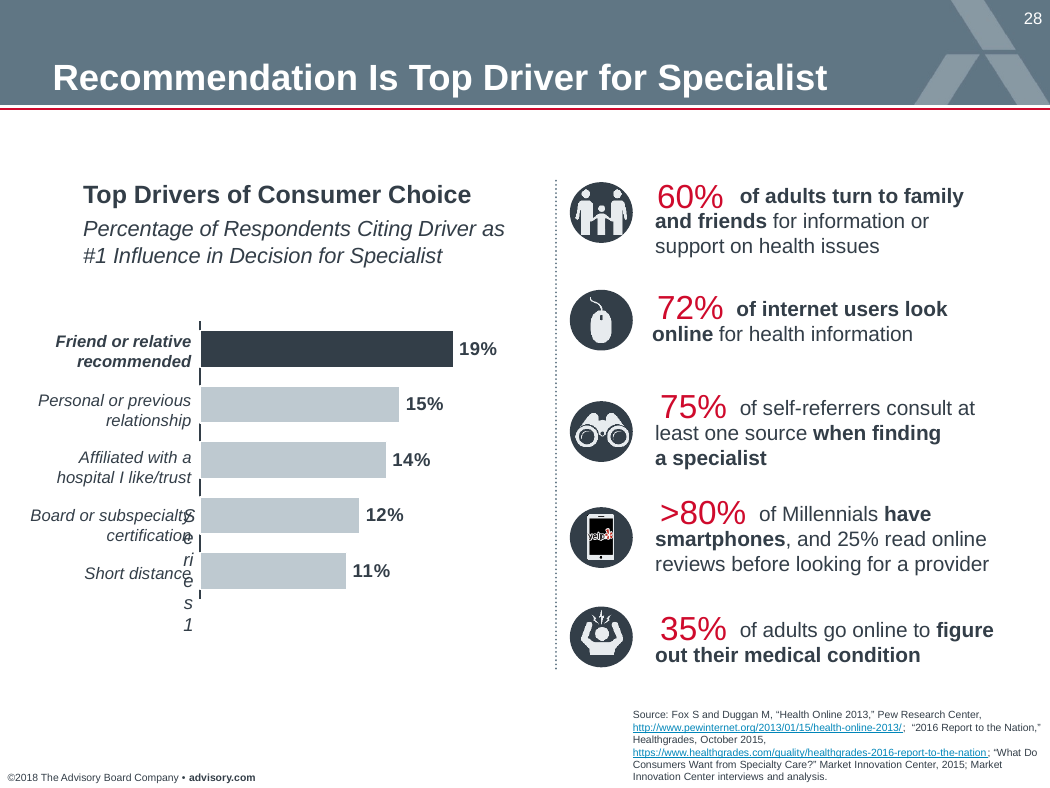
How many drivers (categories) are shown in the chart? 5 Which driver has the highest percentage in the chart? Friend or relative recommended Which is larger: the value for "Personal or previous relationship" or for "Board or subspecialty certification"? Personal or previous relationship What is the value for "Short distance" in the Top Drivers of Consumer Choice chart? 11% What type of chart is used to show the Top Drivers of Consumer Choice? Bar chart Which bar in the chart is shaded a darker colour than the others? Friend or relative recommended What percentage is shown for "Affiliated with a hospital I like/trust"? 14% What is the value for "Board or subspecialty certification"? 12% What is the difference in percentage points between "Affiliated with a hospital I like/trust" and "Short distance"? 3 What percentage of respondents cited "Friend or relative recommended" as the #1 influence? 19% What is the difference in percentage points between "Friend or relative recommended" and "Personal or previous relationship"? 4 Which driver has the lowest percentage in the chart? Short distance